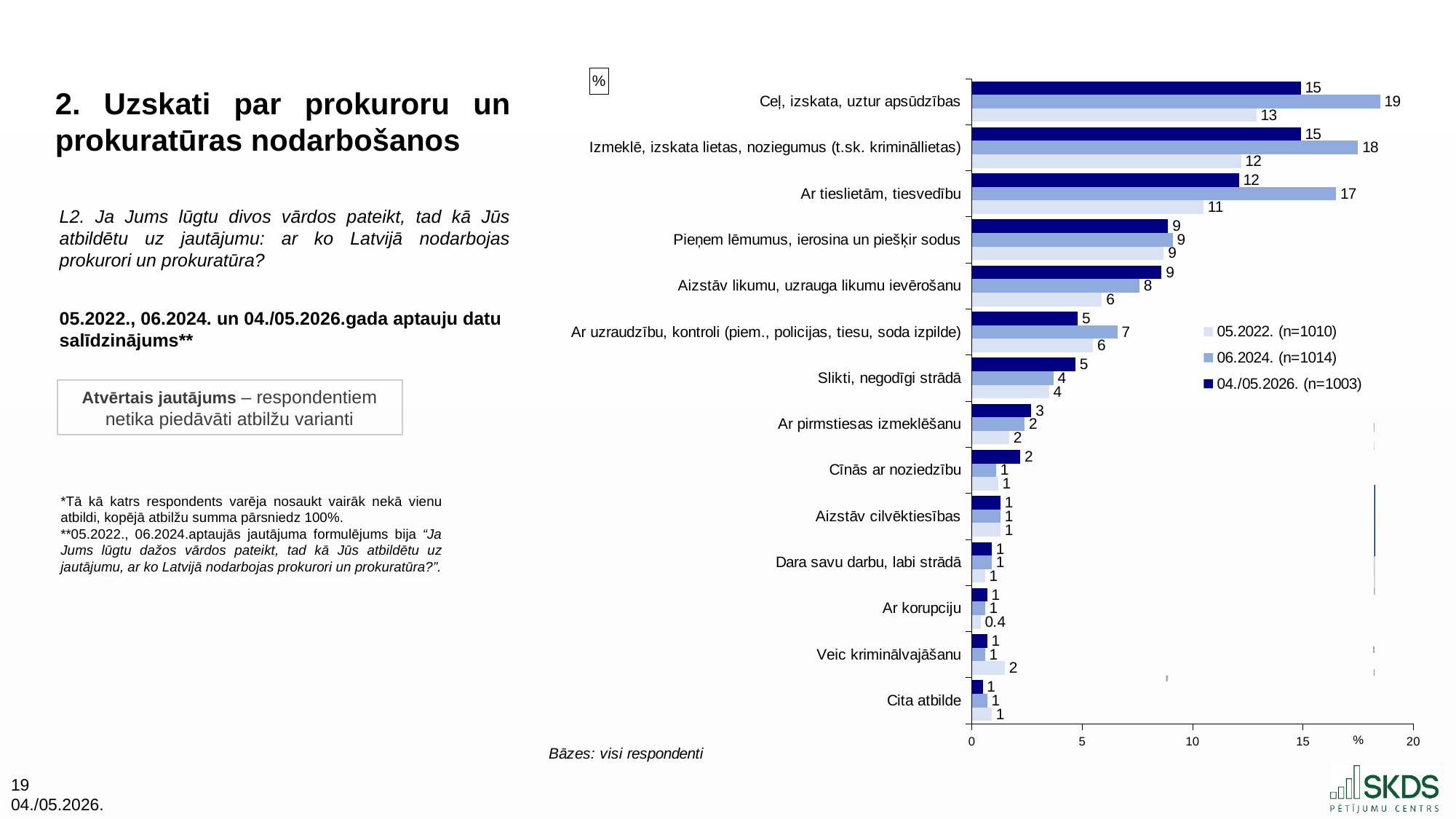
For "Aizstāv likumu, uzrauga likumu ievērošanu", which series has the larger value: 04./05.2026. or 05.2022.? 04./05.2026. What is the value for "Ceļ, izskata, uztur apsūdzības" in the 06.2024. series? 19 What kind of chart is shown on the slide? bar chart How many series does the legend list? 3 What is the difference between the 06.2024. and 05.2022. values for "Izmeklē, izskata lietas, noziegumus (t.sk. krimināllietas)"? 6 Which category has the highest value in the 04./05.2026. series? Ceļ, izskata, uztur apsūdzības and Izmeklē, izskata lietas, noziegumus (t.sk. krimināllietas) (tied at 15) What is the value for "Ar korupciju" in the 05.2022. series? 0.4 What sample size (n) is given in the legend for the 06.2024. series? n=1014 What is the value for "Veic kriminālvajāšanu" in the 05.2022. series? 2 What is the value for "Ar tieslietām, tiesvedību" in the 05.2022. series? 11 How many categories are shown on the chart? 14 What is the difference between the 06.2024. and 04./05.2026. values for "Ar tieslietām, tiesvedību"? 5